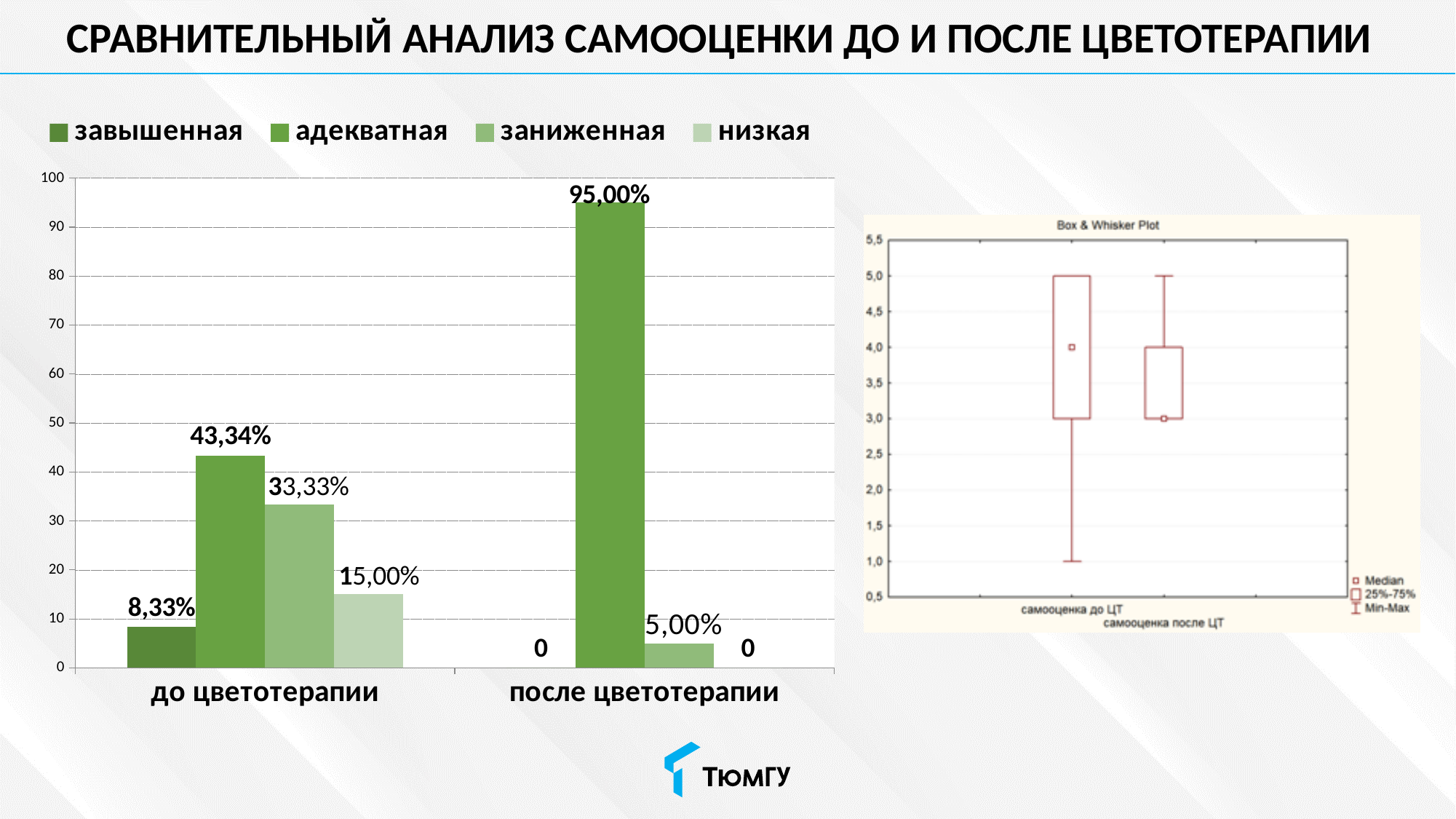
What kind of chart is shown on the left of the slide? bar chart In the bar chart on the left, what is the value for заниженная in the после цветотерапии group? 5,00% In the Box & Whisker Plot on the right, what is the minimum value for самооценка до ЦТ? 1,0 In the bar chart on the left, which series has the highest value in the после цветотерапии group? адекватная In the bar chart on the left, what is the value for адекватная in the до цветотерапии group? 43,34% In the bar chart on the left, which series has the lowest value in the до цветотерапии group? завышенная In the bar chart on the left, which is larger in the до цветотерапии group: заниженная or низкая? заниженная In the bar chart on the left, how many category groups are shown on the x axis? 2 In the bar chart on the left, what is the value for низкая in the до цветотерапии group? 15,00% In the Box & Whisker Plot on the right, what is the median for самооценка до ЦТ? 4,0 In the bar chart on the left, how many series does the legend list? 4 In the bar chart on the left, what is the difference between the адекватная values after and before colour therapy (после минус до)? 51,66%